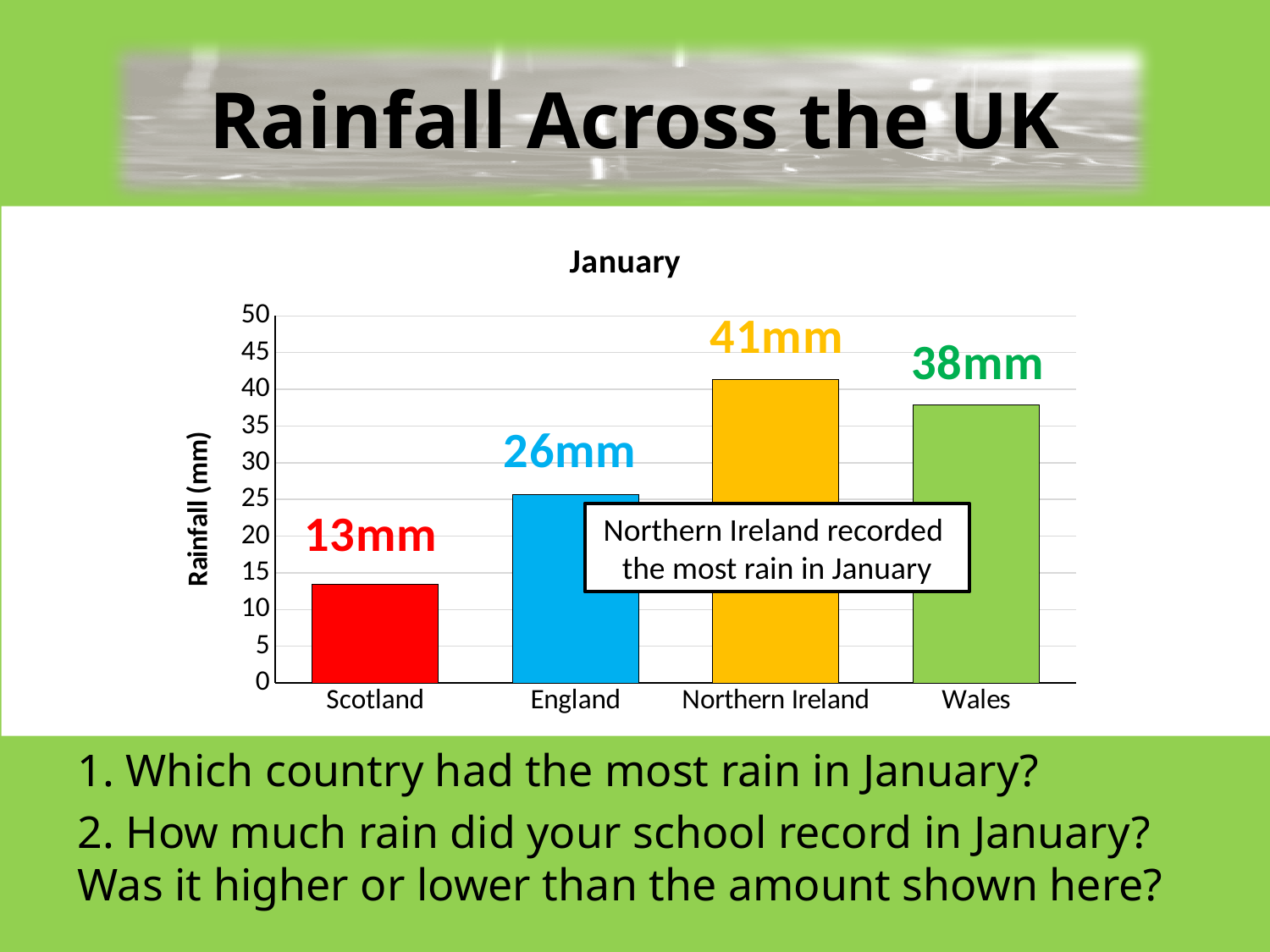
What is the difference in rainfall between Northern Ireland and Scotland? 28mm What is the rainfall value shown for Wales? 38mm What kind of chart is shown on the slide? Bar chart What is the rainfall value shown for Northern Ireland? 41mm How many countries are shown in the chart? 4 What is the rainfall value shown for England? 26mm Which country has the highest rainfall in the chart? Northern Ireland Which country has the lowest rainfall in the chart? Scotland What is the difference in rainfall between Wales and England? 12mm What is the rainfall value shown for Scotland? 13mm Which has more rainfall, England or Wales? Wales What is the title of the chart? January